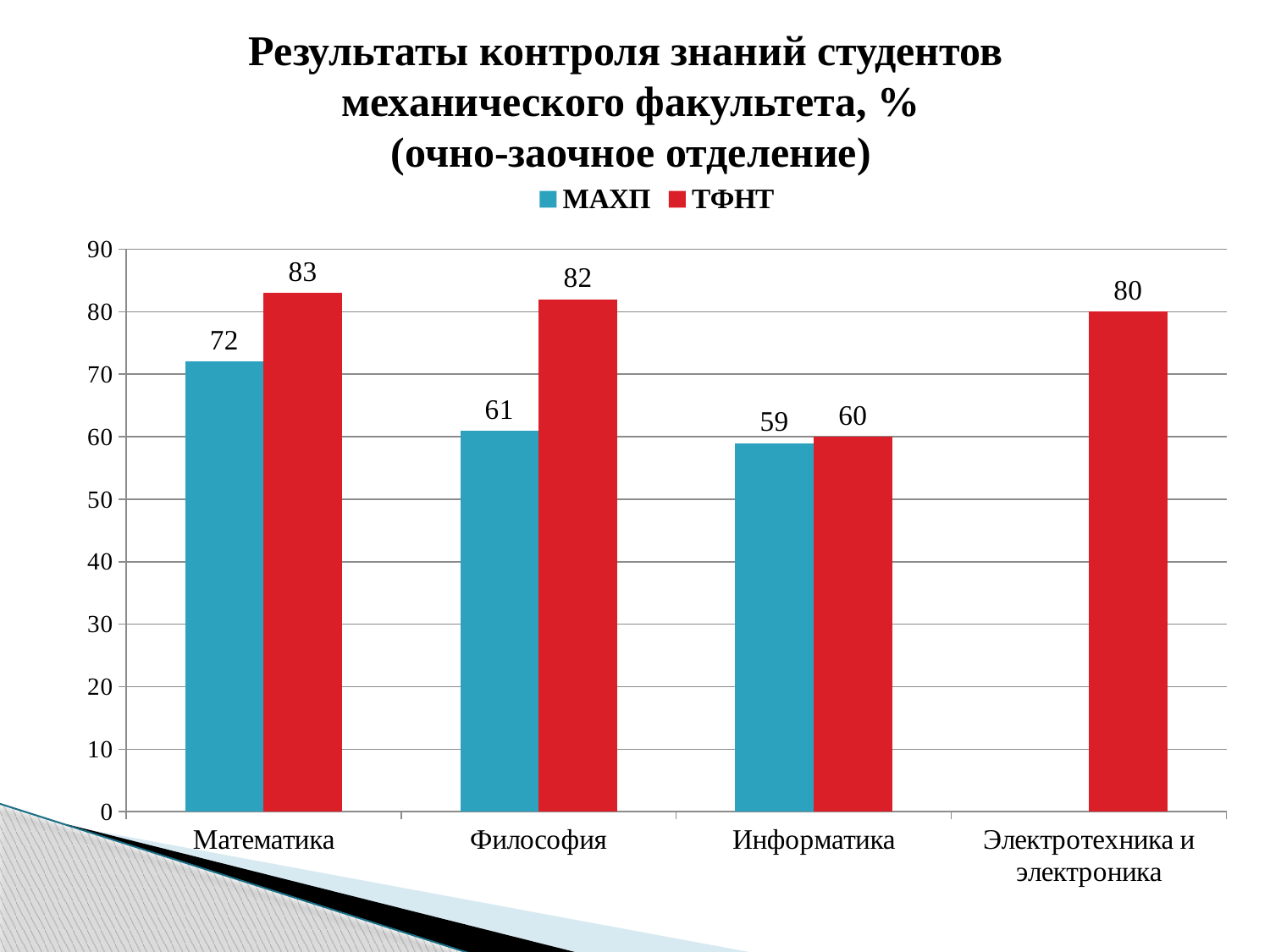
Which category has the highest value for ТФНТ? Математика Which is larger in Информатика, МАХП or ТФНТ? ТФНТ Is the value for МАХП in Философия greater or less than 70? less What is the value for ТФНТ in Электротехника и электроника? 80 Which category has the lowest value for МАХП? Информатика What is the value for МАХП in Математика? 72 What kind of chart is shown on the slide? bar chart What is the difference between ТФНТ and МАХП in Философия? 21 How many series does the legend list? 2 Which colour represents the ТФНТ series? red What is the value for ТФНТ in Философия? 82 How many categories are shown on the x axis? 4